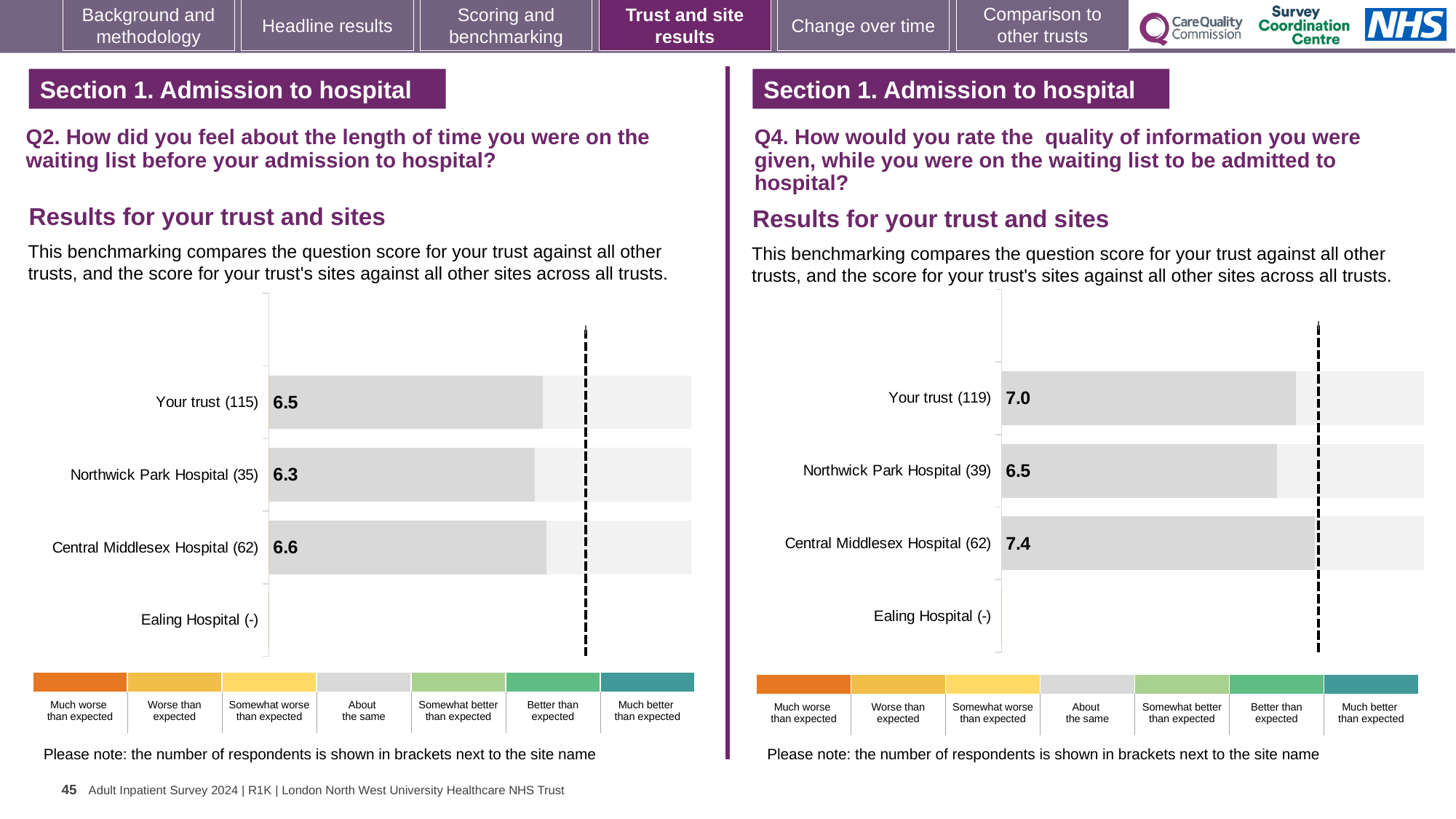
In the Q4 chart on the right, what is the score for Northwick Park Hospital? 6.5 In the Q2 chart on the left, what is the score for Northwick Park Hospital? 6.3 In the Q2 chart on the left, how many respondents are shown in brackets for Your trust? 115 In the Q4 chart on the right, what is the difference between the scores for Central Middlesex Hospital and Northwick Park Hospital? 0.9 What kind of chart is used in the Q4 chart on the right? Bar chart In the Q4 chart on the right, what is the score for Central Middlesex Hospital? 7.4 In the Q4 chart on the right, which has the larger score, Your trust or Northwick Park Hospital? Your trust How many categories (trust and sites) are listed on the y axis of the Q2 chart on the left? 4 In the Q2 chart on the left, what is the score for Your trust? 6.5 In the Q2 chart on the left, which site or trust has the highest score? Central Middlesex Hospital In the Q2 chart on the left, what is the difference between the scores for Central Middlesex Hospital and Your trust? 0.1 In the Q4 chart on the right, which site or trust has the lowest score? Northwick Park Hospital